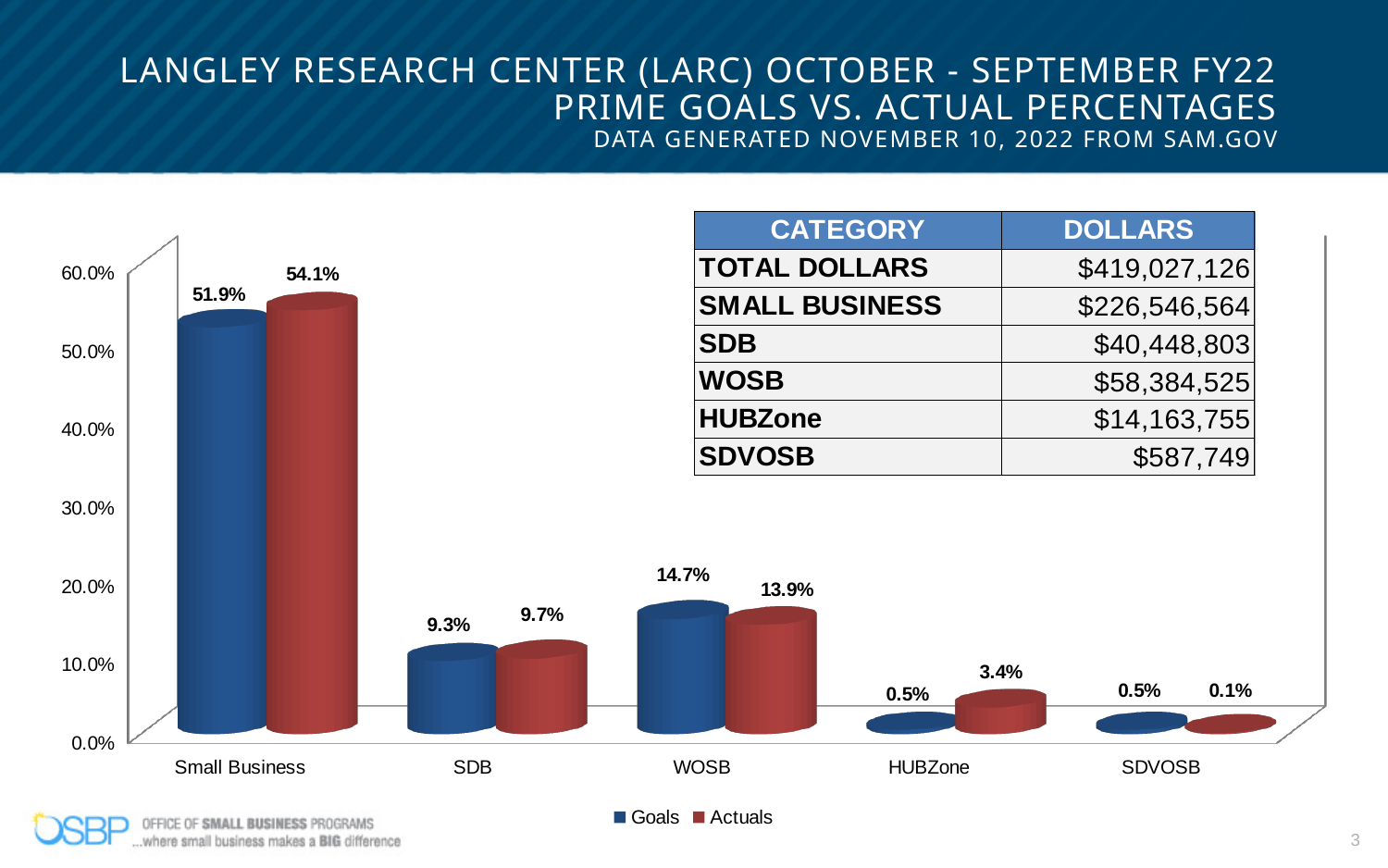
What is the Actuals value for HUBZone? 3.4% Which is larger for SDB, the Goals value or the Actuals value? Actuals Which category has the highest Actuals value? Small Business How many series does the chart legend list? 2 What is the difference between the Goals and Actuals values for WOSB? 0.8% What is the difference between the Actuals and Goals values for Small Business? 2.2% Which is larger for SDVOSB, the Goals value or the Actuals value? Goals What is the Actuals value for WOSB? 13.9% How many categories are shown on the x axis of the chart? 5 What is the Goals value for Small Business? 51.9% What kind of chart is shown on the slide? Bar chart Which category has the lowest Actuals value? SDVOSB